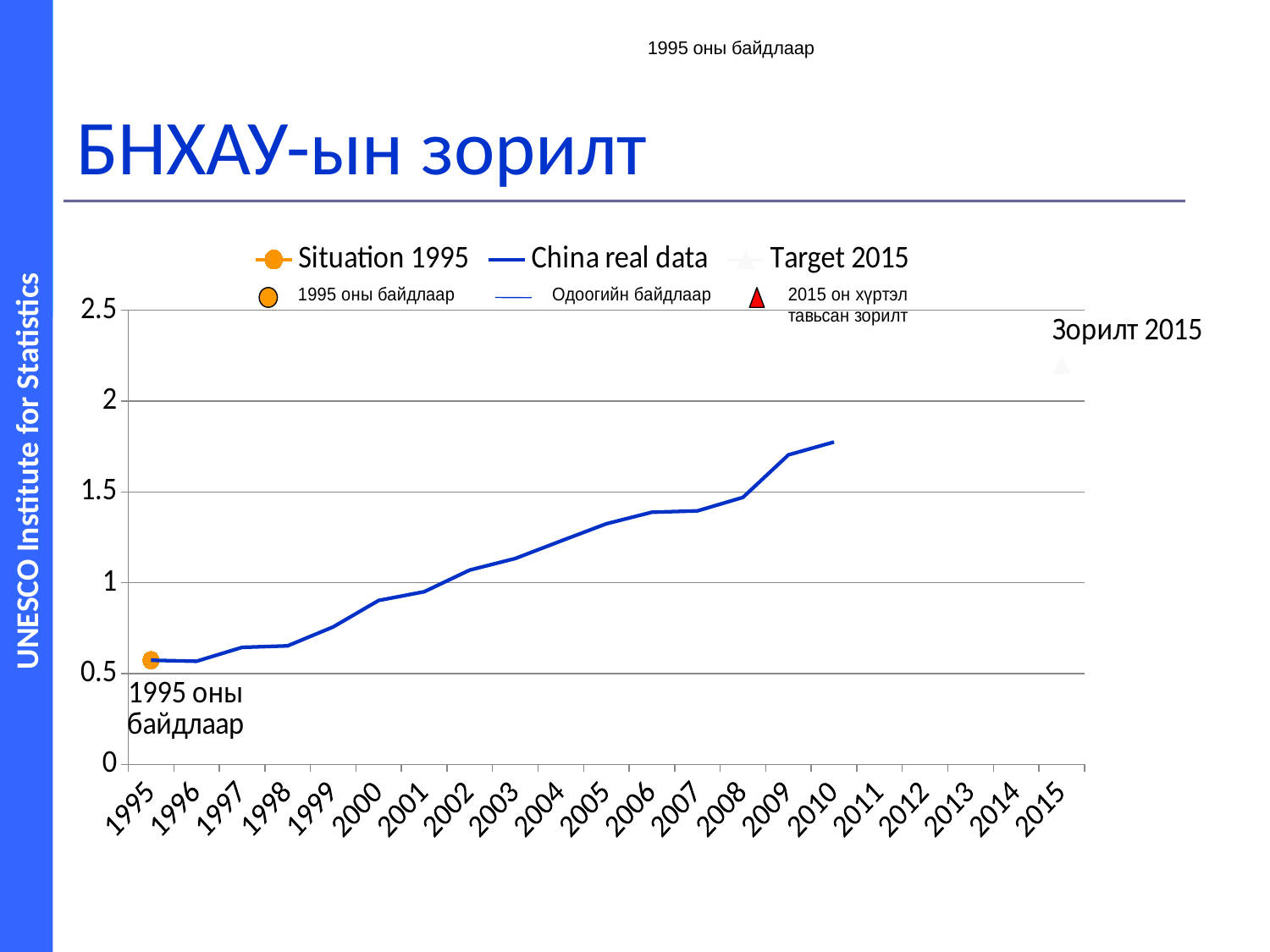
Which is larger on the China real data line, the value for 1995 or the value for 2010? 2010 Is the China real data value for 2000 greater or less than 1? less Which year has the highest value on the China real data line? 2010 What colour is the China real data line? blue How many series does the chart legend list? 3 Is the China real data value for 2005 greater or less than 1? greater Does the China real data line rise or fall from 1995 to 2010? rise How many years are labelled along the x axis of the chart? 21 What kind of chart is shown on the slide? line chart Is the Situation 1995 value greater or less than 1? less